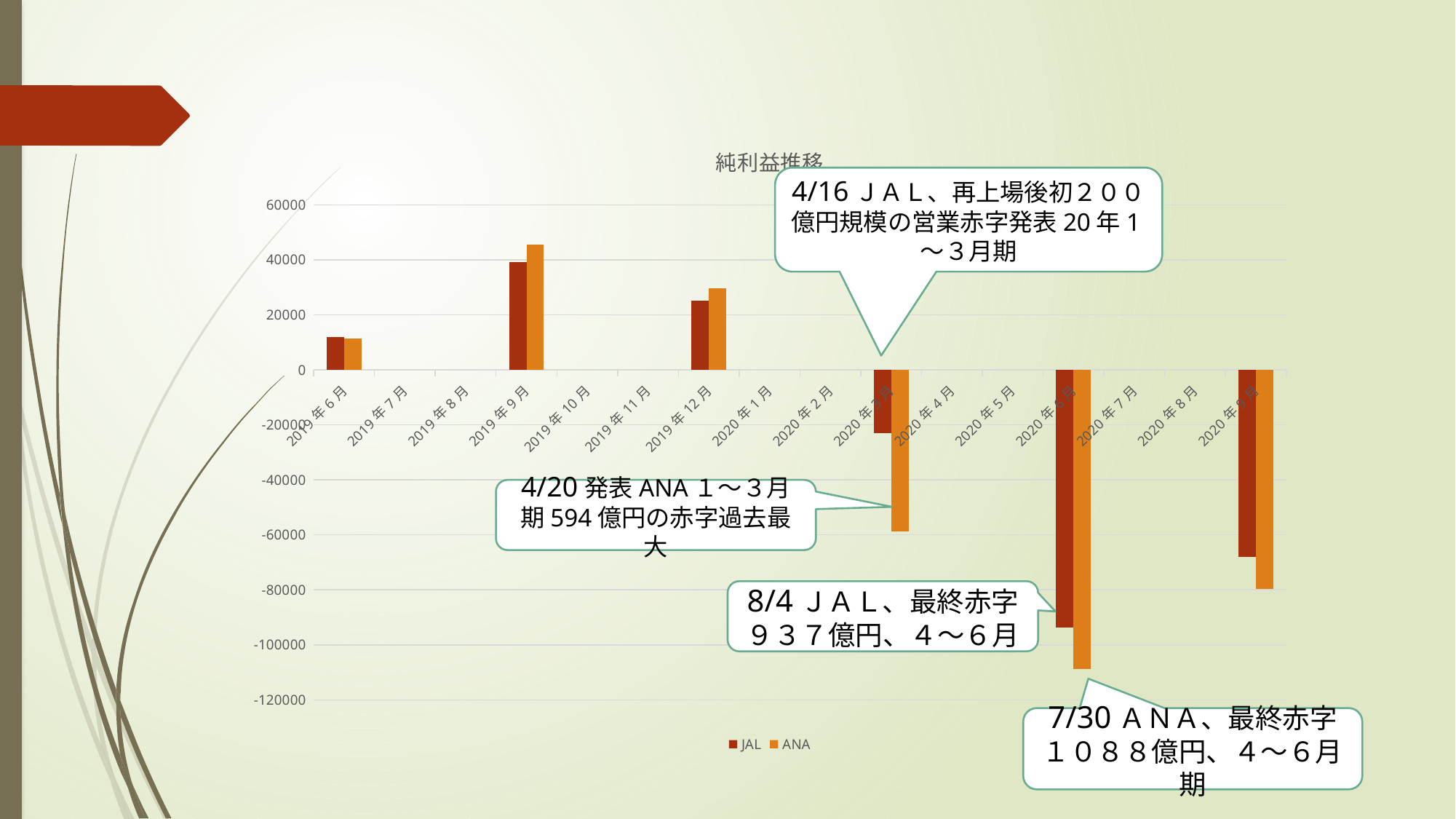
Is the value for ANA in 2020年3月 greater or less than -40000? less Which series is drawn in orange? ANA In 2020年6月, which series has the lower value, JAL or ANA? ANA In which month does the ANA series reach its highest value? 2019年9月 Is the value for ANA in 2020年6月 greater or less than -100000? less How many month categories are shown on the x axis? 16 What kind of chart is shown on the slide? bar chart In 2019年9月, which series has the larger value, JAL or ANA? ANA In which month does the ANA series reach its lowest value? 2020年6月 Is the value for JAL in 2019年9月 greater or less than 20000? greater How many series does the legend list? 2 What is the title of the chart? 純利益推移